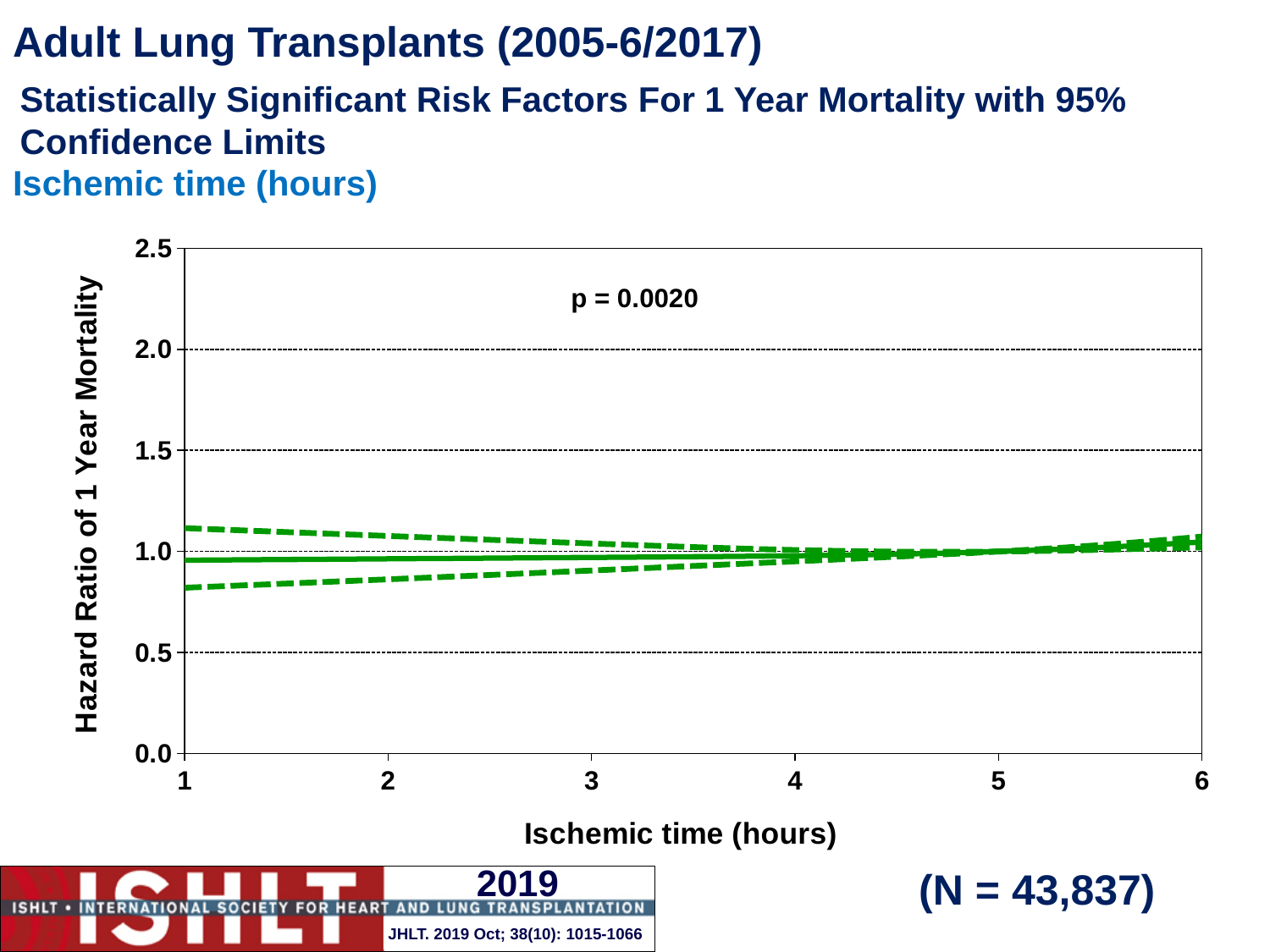
How many tick marks are labelled on the x axis (ischemic time)? 6 Is the upper confidence limit (upper dashed line) at 1 hour greater or less than 1.0? greater Does the solid hazard ratio line rise or fall as ischemic time increases from 1 to 6 hours? rises What is the title of the y axis? Hazard Ratio of 1 Year Mortality What is the highest value labelled on the y axis? 2.5 Is the lower confidence limit (lower dashed line) at 1 hour greater or less than 1.0? less What p-value is printed on the chart? p = 0.0020 Is the hazard ratio (solid line) at 6 hours greater or less than 0.5? greater How many lines are plotted on the chart? 3 What is the lowest value labelled on the x axis? 1 What kind of chart is shown on the slide? line chart